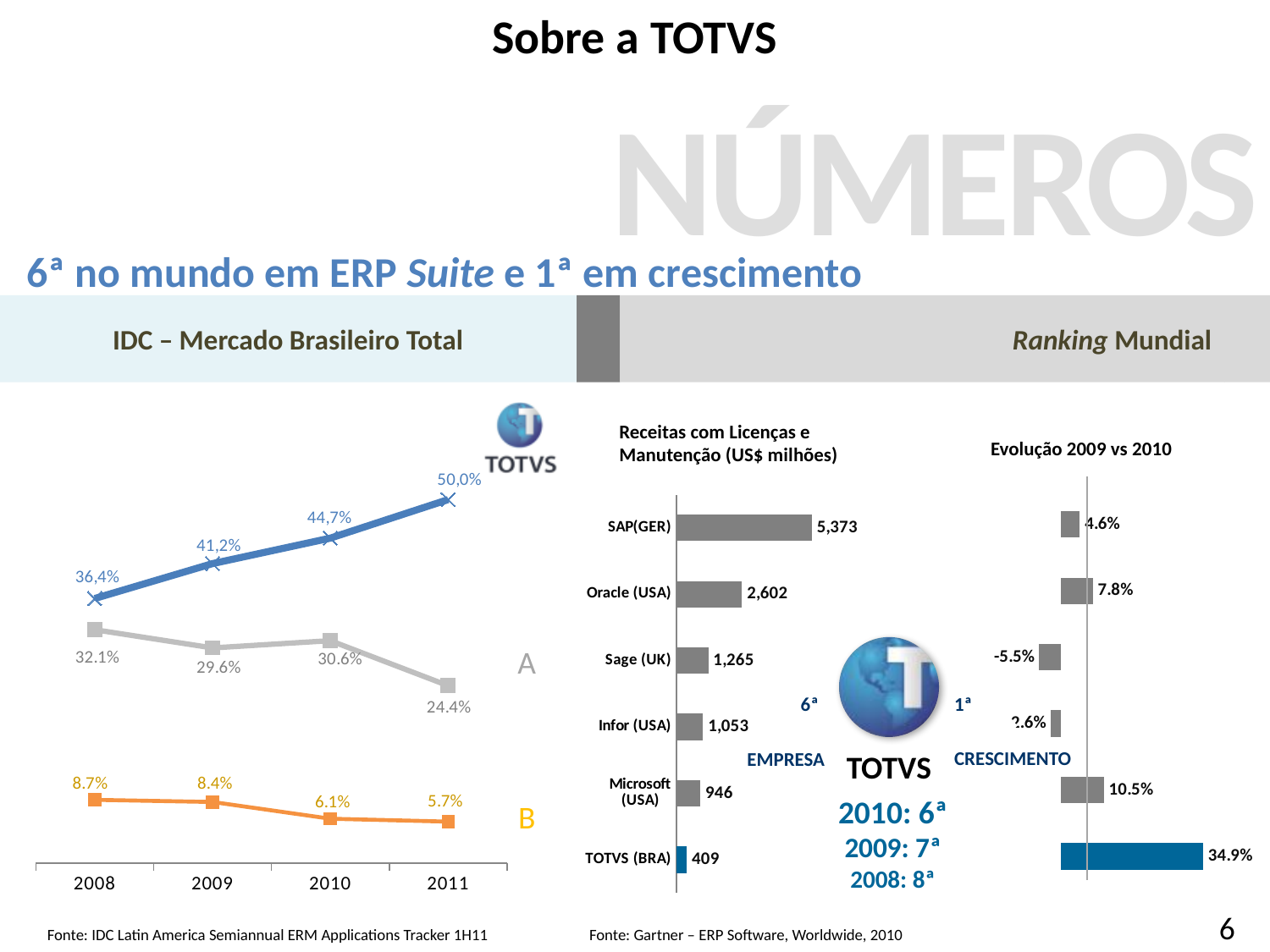
In the 'IDC – Mercado Brasileiro Total' line chart, what is the difference between the B values for 2008 and 2011? 3.0% In the 'Evolução 2009 vs 2010' chart, what is the value for TOTVS? 34.9% In the 'Evolução 2009 vs 2010' chart, which company has the highest growth? TOTVS In the 'Receitas com Licenças e Manutenção (US$ milhões)' chart, what is the value for TOTVS (BRA)? 409 In the 'Receitas com Licenças e Manutenção (US$ milhões)' chart, what is the value for SAP(GER)? 5,373 In the 'Receitas com Licenças e Manutenção (US$ milhões)' chart, which company has the lowest value? TOTVS (BRA) In the 'Receitas com Licenças e Manutenção (US$ milhões)' chart, what is the difference between Oracle (USA) and Sage (UK)? 1,337 In the 'Evolução 2009 vs 2010' chart, which is larger, the value for Oracle or the value for Microsoft? Microsoft In the 'IDC – Mercado Brasileiro Total' line chart, what is the value of series A in 2009? 29.6% In the 'Receitas com Licenças e Manutenção (US$ milhões)' chart, how many companies are shown? 6 In the 'IDC – Mercado Brasileiro Total' line chart, does the TOTVS series rise or fall from 2008 to 2011? rise In the 'IDC – Mercado Brasileiro Total' line chart, what is the TOTVS value for 2011? 50,0%